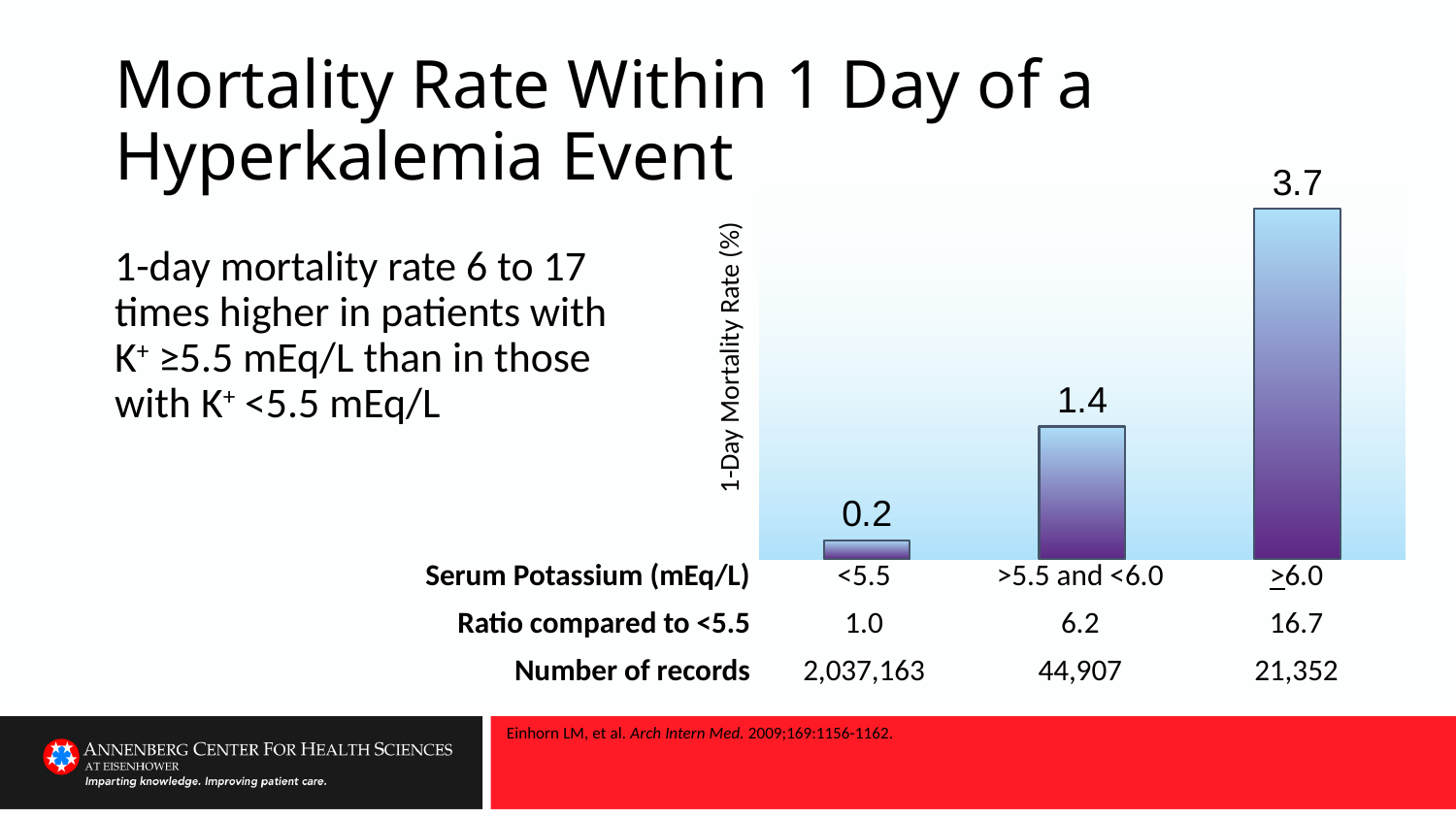
What is the 1-day mortality rate for the serum potassium category >5.5 and <6.0 mEq/L? 1.4 Which has a higher 1-day mortality rate: the >5.5 and <6.0 category or the ≥6.0 category? ≥6.0 What is the difference in 1-day mortality rate between the >5.5 and <6.0 category and the <5.5 category? 1.2 Which serum potassium category has the highest 1-day mortality rate? ≥6.0 What is the difference in 1-day mortality rate between the ≥6.0 and the <5.5 serum potassium categories? 3.5 What is the 1-day mortality rate for the serum potassium category ≥6.0 mEq/L? 3.7 What is the 1-day mortality rate for the serum potassium category <5.5 mEq/L? 0.2 What type of chart is shown on the slide? Bar chart How many serum potassium categories are plotted in the chart? 3 Do the 1-day mortality rates rise or fall as serum potassium increases along the x axis? Rise What is the label of the vertical axis of the chart? 1-Day Mortality Rate (%) Which serum potassium category has the lowest 1-day mortality rate? <5.5